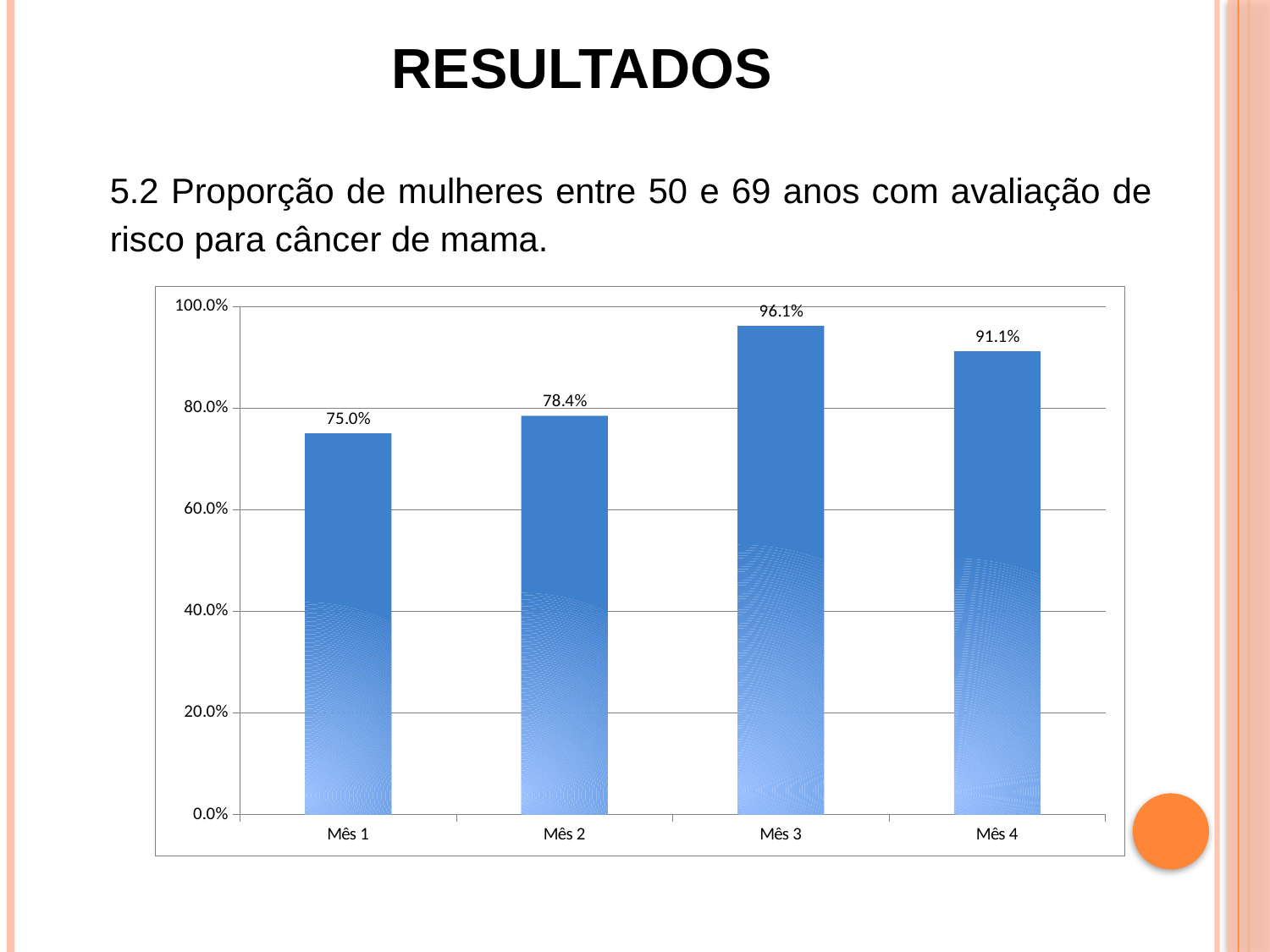
Which month has the highest value? Mês 3 What is the value for Mês 4? 91.1% What kind of chart is shown on the slide? Bar chart What is the difference between the values for Mês 3 and Mês 4? 5.0% Which is larger, the value for Mês 2 or the value for Mês 4? Mês 4 What is the value for Mês 1? 75.0% Is the value for Mês 2 greater or less than 80.0%? less What is the value for Mês 3? 96.1% Which month has the lowest value? Mês 1 What is the value for Mês 2? 78.4% What is the difference between the values for Mês 3 and Mês 1? 21.1% How many months are shown on the x axis? 4